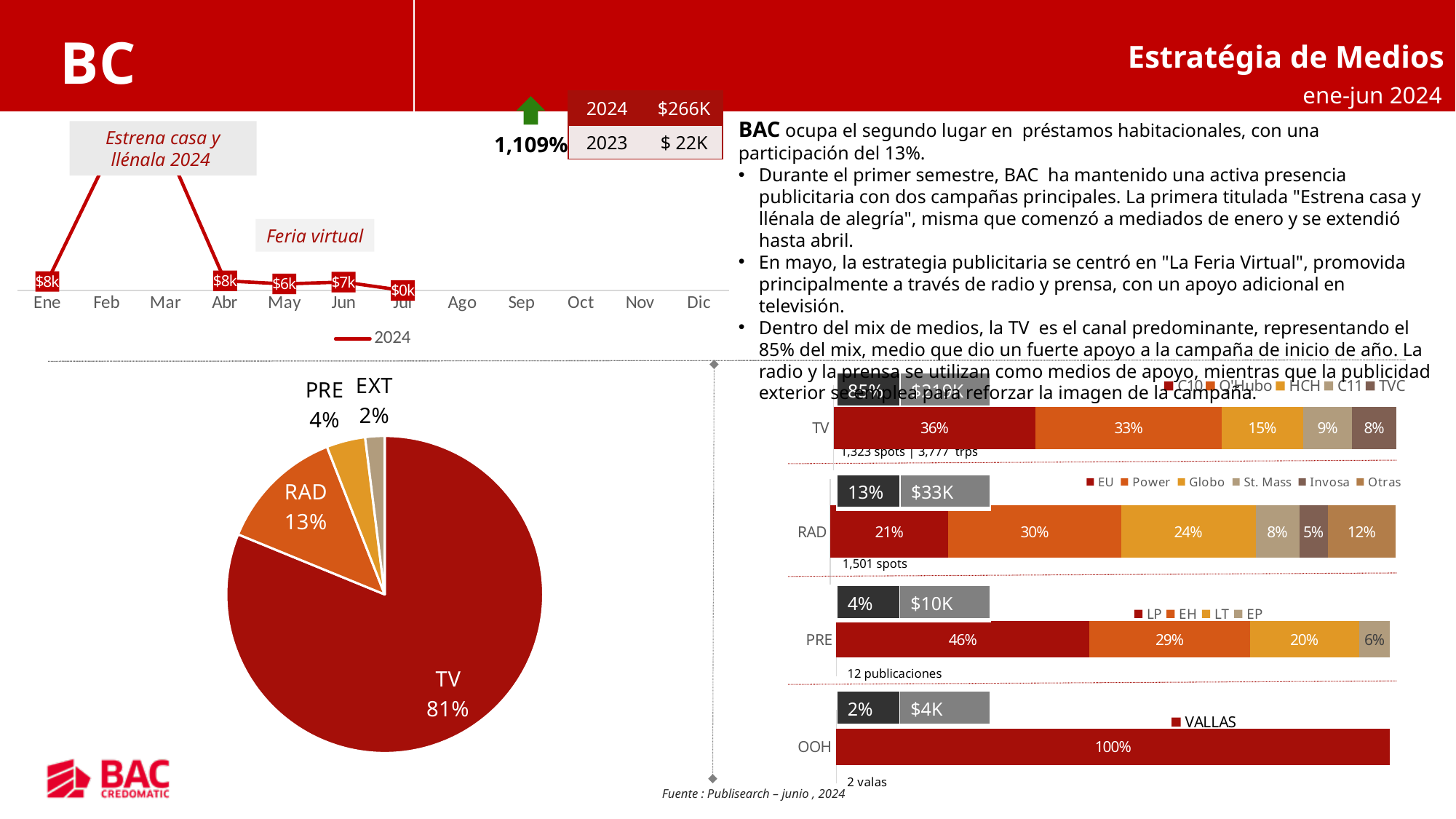
In the RAD stacked bar on the right, how many series does the legend list? 6 In the line chart at the top left, what is the value for May? $6k How many slices does the pie chart have? 4 In the PRE stacked bar on the right, what is the difference between LP and EH? 17% In the pie chart, what share does RAD have? 13% In the pie chart, what share does TV have? 81% In the PRE stacked bar on the right, what is the value for LP? 46% In the pie chart, which category has the smallest slice? EXT In the line chart at the top left, what is the value for Jun? $7k In the line chart at the top left, what series does the legend list? 2024 In the RAD stacked bar on the right, what is the value for Power? 30%